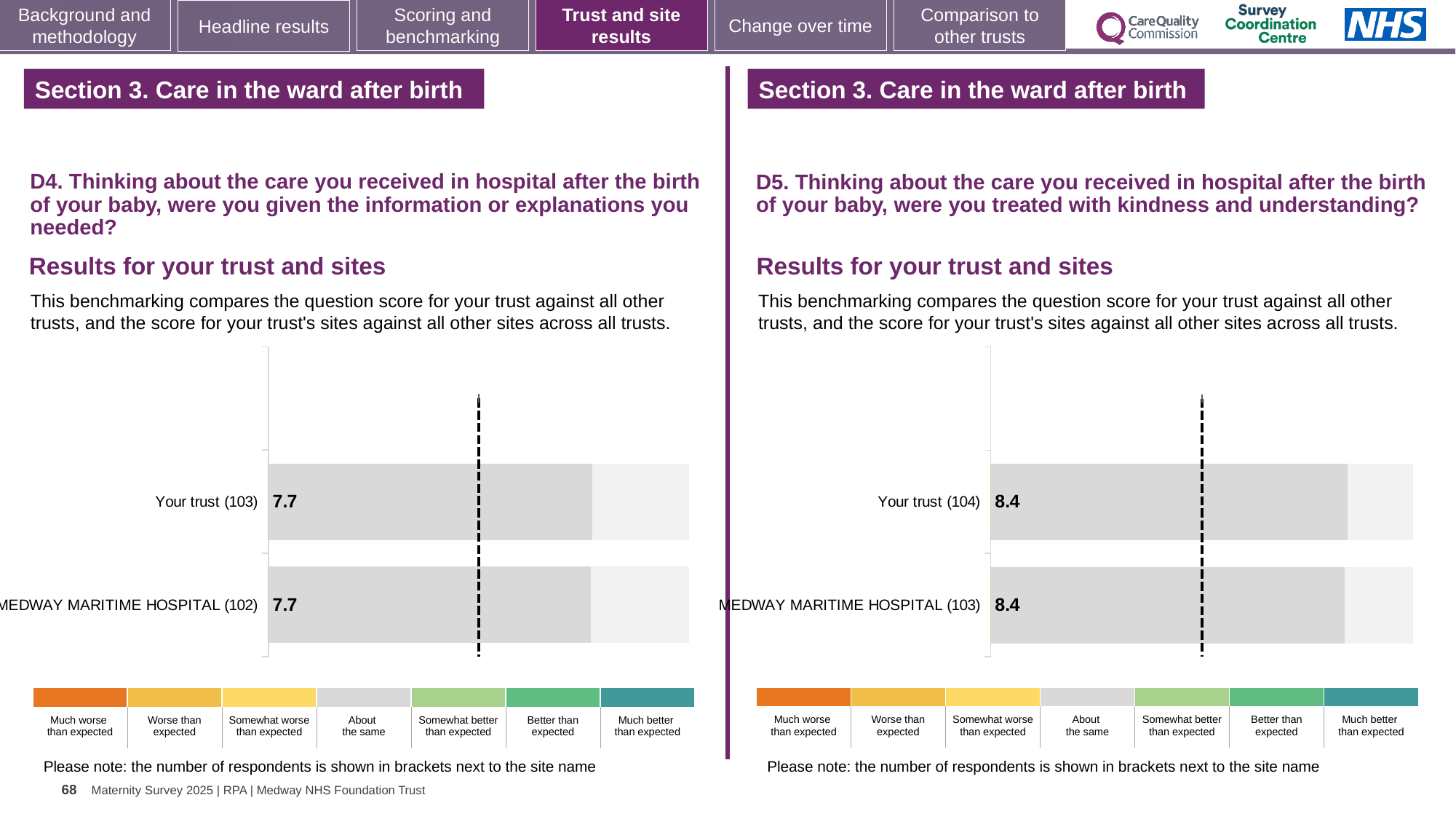
On the right chart (D5), how many respondents are shown in brackets next to MEDWAY MARITIME HOSPITAL? 103 On the right chart (D5), what is the score for MEDWAY MARITIME HOSPITAL? 8.4 How many bars are plotted on the left chart (D4)? 2 On the left chart (D4), what is the difference between the score for Your trust and the score for MEDWAY MARITIME HOSPITAL? 0 On the left chart (D4), what is the score for Your trust? 7.7 On the right chart (D5), what is the difference between the score for Your trust and the score for MEDWAY MARITIME HOSPITAL? 0 On the right chart (D5), what is the score for Your trust? 8.4 How many bars are plotted on the right chart (D5)? 2 Is the score for Your trust on the right chart (D5) larger or smaller than the score for Your trust on the left chart (D4)? Larger What kind of chart is used on the left (D4)? Bar chart On the left chart (D4), what is the score for MEDWAY MARITIME HOSPITAL? 7.7 On the left chart (D4), how many respondents are shown in brackets next to Your trust? 103